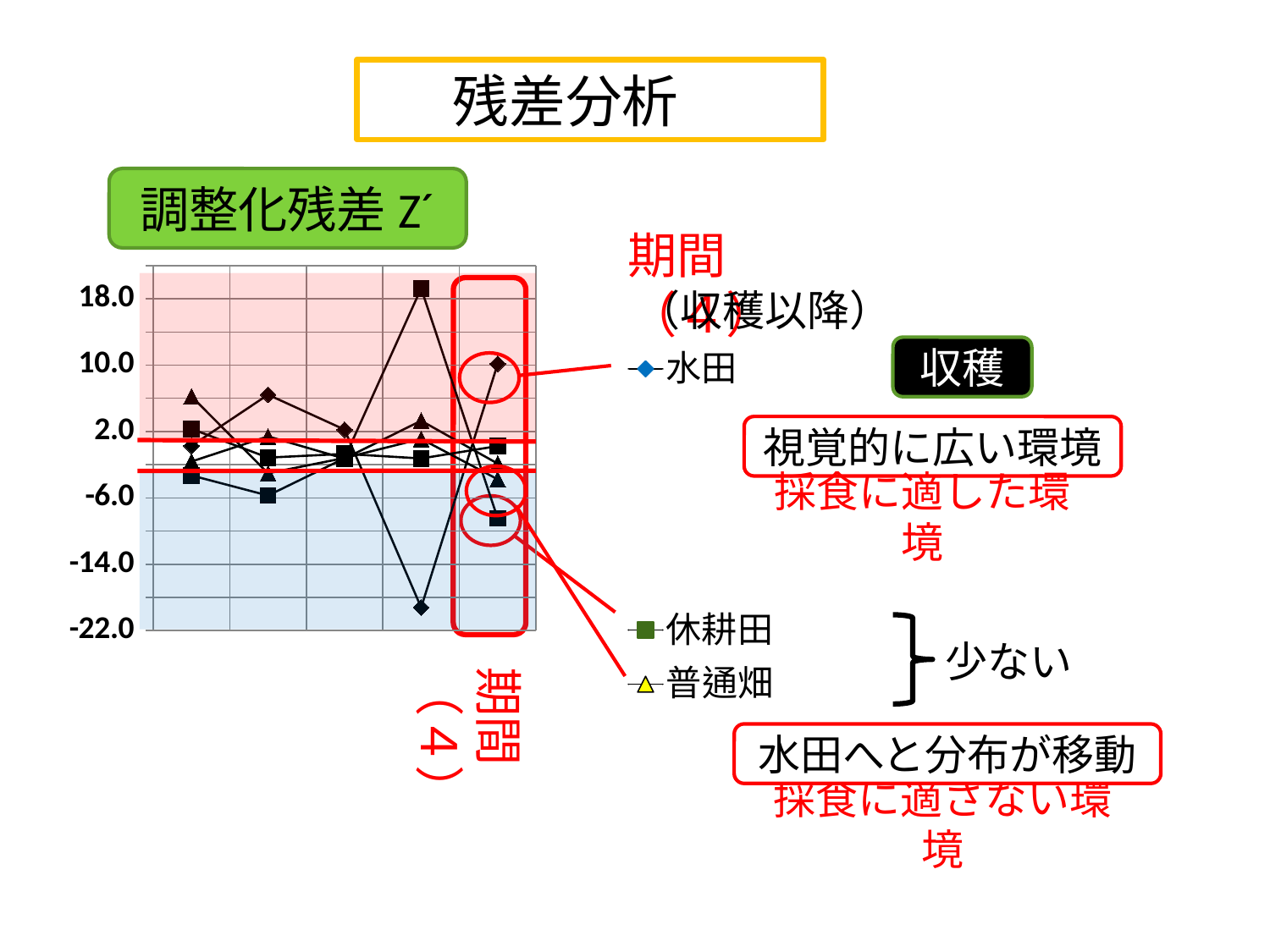
What is the title shown above the chart? 調整化残差 Z′ Which series does the diamond marker in the legend represent? 水田 Is the highest point of 休耕田 greater or less than 10.0? greater At the last x position (the red-boxed period), is the value for 水田 greater or less than 2.0? greater What kind of chart is shown on the slide? line chart What is the lowest value labelled on the vertical axis? -22.0 How many points along the x axis does each series have? 5 At the last x position, which is larger: the value for 水田 or the value for 休耕田? 水田 Is the lowest point of 水田 greater or less than -14.0? less What is the highest value labelled on the vertical axis? 18.0 Which series reaches the highest point on the chart? 休耕田 Which series reaches the lowest point on the chart? 水田